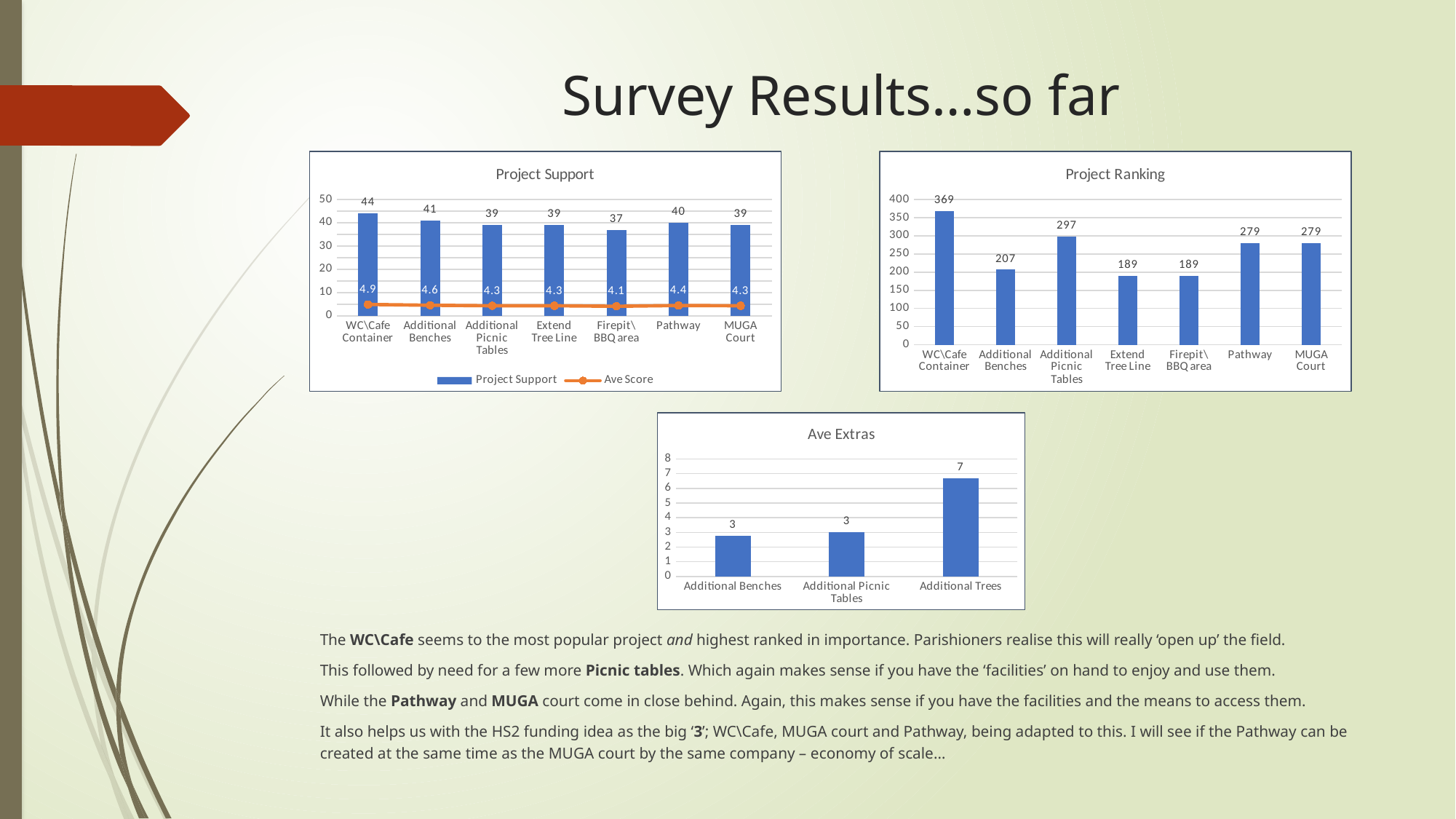
In the Project Ranking chart, what is the value for Additional Picnic Tables? 297 In the Project Ranking chart, which category has the highest value? WC\Cafe Container In the Project Support chart, what is the difference between the Project Support values for WC\Cafe Container and Additional Benches? 3 In the Project Support chart, what is the Project Support value for WC\Cafe Container? 44 In the Ave Extras chart, what is the value for Additional Trees? 7 In the Project Ranking chart, what is the difference between the values for WC\Cafe Container and Additional Benches? 162 In the Project Ranking chart, which is larger, the value for Pathway or the value for Extend Tree Line? Pathway In the Project Support chart, how many series does the legend list? 2 What kind of chart is the Ave Extras chart? Bar chart In the Project Support chart, which category has the lowest Project Support value? Firepit\BBQ area In the Project Support chart, what is the Ave Score for Firepit\BBQ area? 4.1 In the Project Ranking chart, how many categories are shown? 7